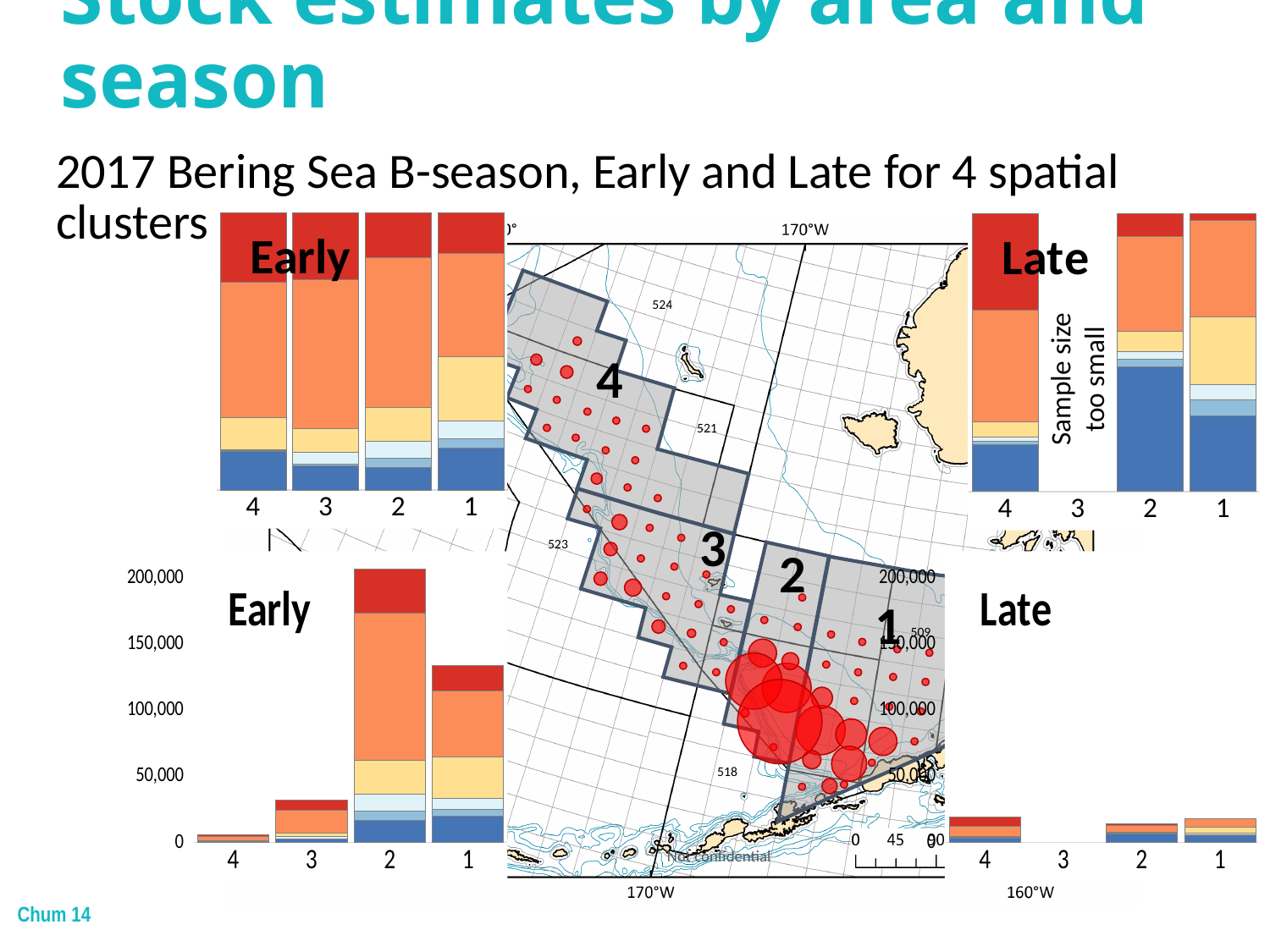
In the bottom-left 'Early' chart, which cluster has the tallest bar? 2 In the bottom-left 'Early' chart, which cluster has the shortest bar? 4 What kind of chart is the bottom-left 'Early' chart? Stacked bar chart In the top-right 'Late' chart, what note is given in place of the bar for cluster 3? Sample size too small In the bottom-left 'Early' chart, is the total for cluster 3 greater or less than 50,000? less In the bottom-left 'Early' chart, is the total for cluster 1 greater or less than 150,000? less In the bottom-left 'Early' chart, is the total for cluster 1 greater or less than 100,000? greater How many clusters are shown on the x axis of the bottom-left 'Early' chart? 4 In the bottom-left 'Early' chart, which bar is taller, cluster 2 or cluster 1? Cluster 2 How many clusters are labelled on the x axis of the top-left 'Early' chart? 4 What is the highest value labelled on the y axis of the bottom-left 'Early' chart? 200,000